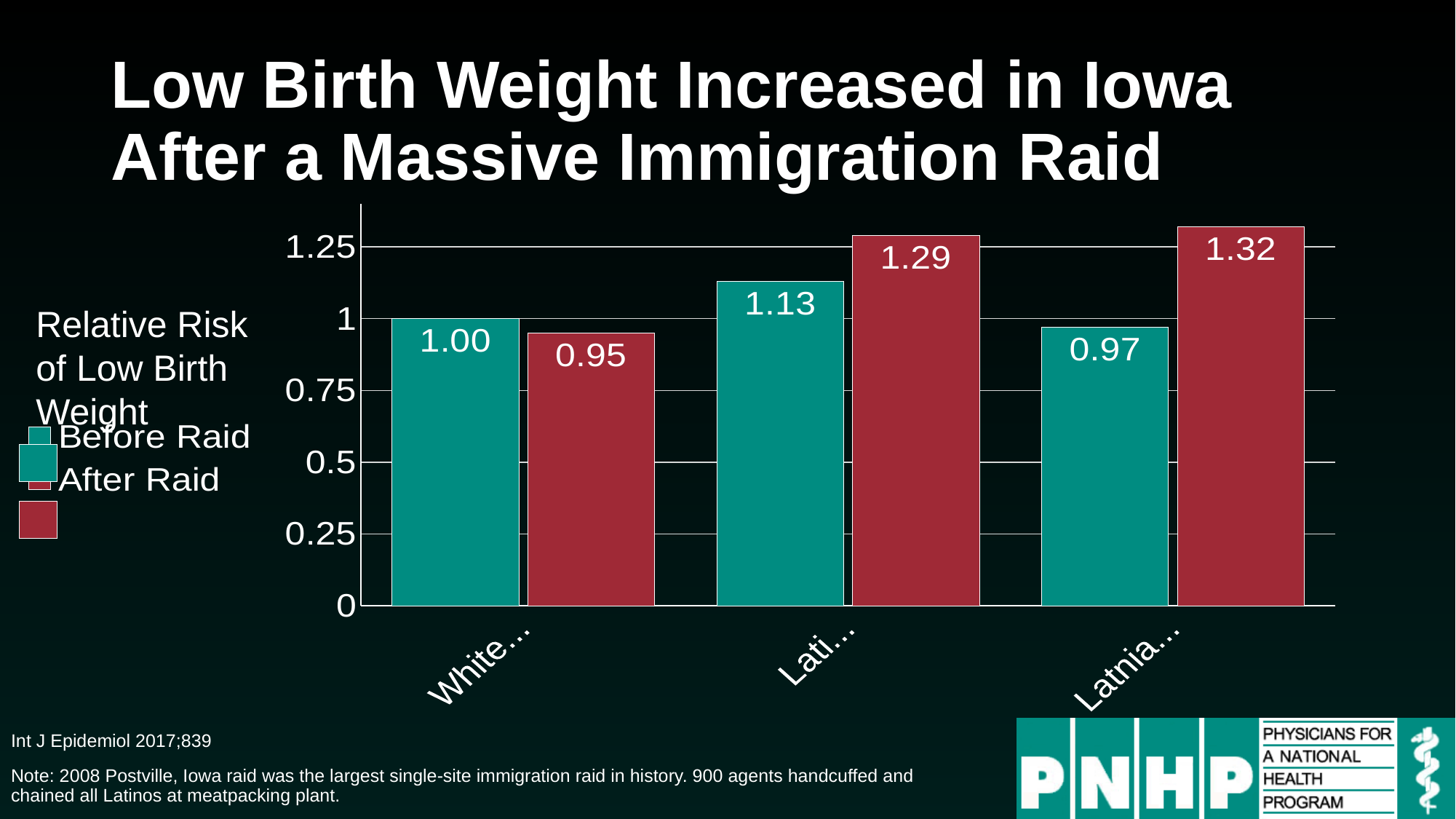
What is the After Raid value for the second category group (labelled 'Lati…')? 1.29 In the first category group, which is larger: the Before Raid value or the After Raid value? Before Raid In the third category group, what is the difference between the After Raid and Before Raid values? 0.35 What is the After Raid value for the third category group (labelled 'Latnia…')? 1.32 Which category group has the highest After Raid value? the third group (Latnia…) What are the two legend entries of the chart? Before Raid, After Raid In the second category group, what is the difference between the After Raid and Before Raid values? 0.16 Which bar has the lowest value in the chart? After Raid in the first group (0.95) What kind of chart is shown on the slide? bar chart How many category groups are plotted on the x axis? 3 How many series does the legend list? 2 What is the Before Raid value for the first category group (labelled 'White…')? 1.00